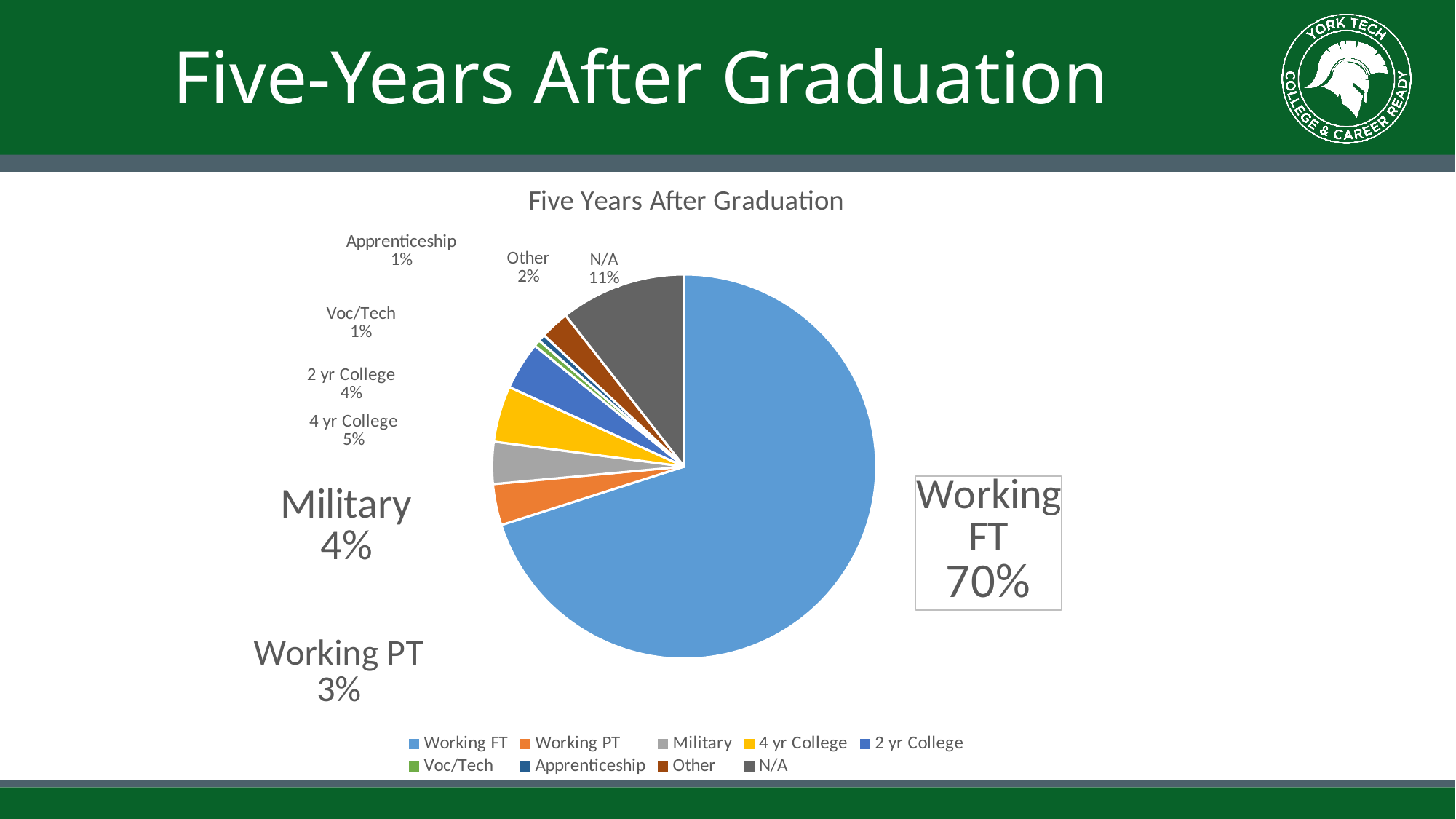
What kind of chart is shown on the slide? Pie chart How many categories does the legend list? 9 Which is larger, the share for 4 yr College or the share for Working PT? 4 yr College What percentage of graduates are Working FT five years after graduation? 70% What is the difference in percentage points between Working FT and N/A? 59 What percentage is shown for Military? 4% What percentage is shown for Apprenticeship? 1% What is the chart's title? Five Years After Graduation What colour is the Working FT slice? Blue Which category has the largest slice of the pie? Working FT What percentage is shown for 4 yr College? 5% What share of the pie is labelled N/A? 11%